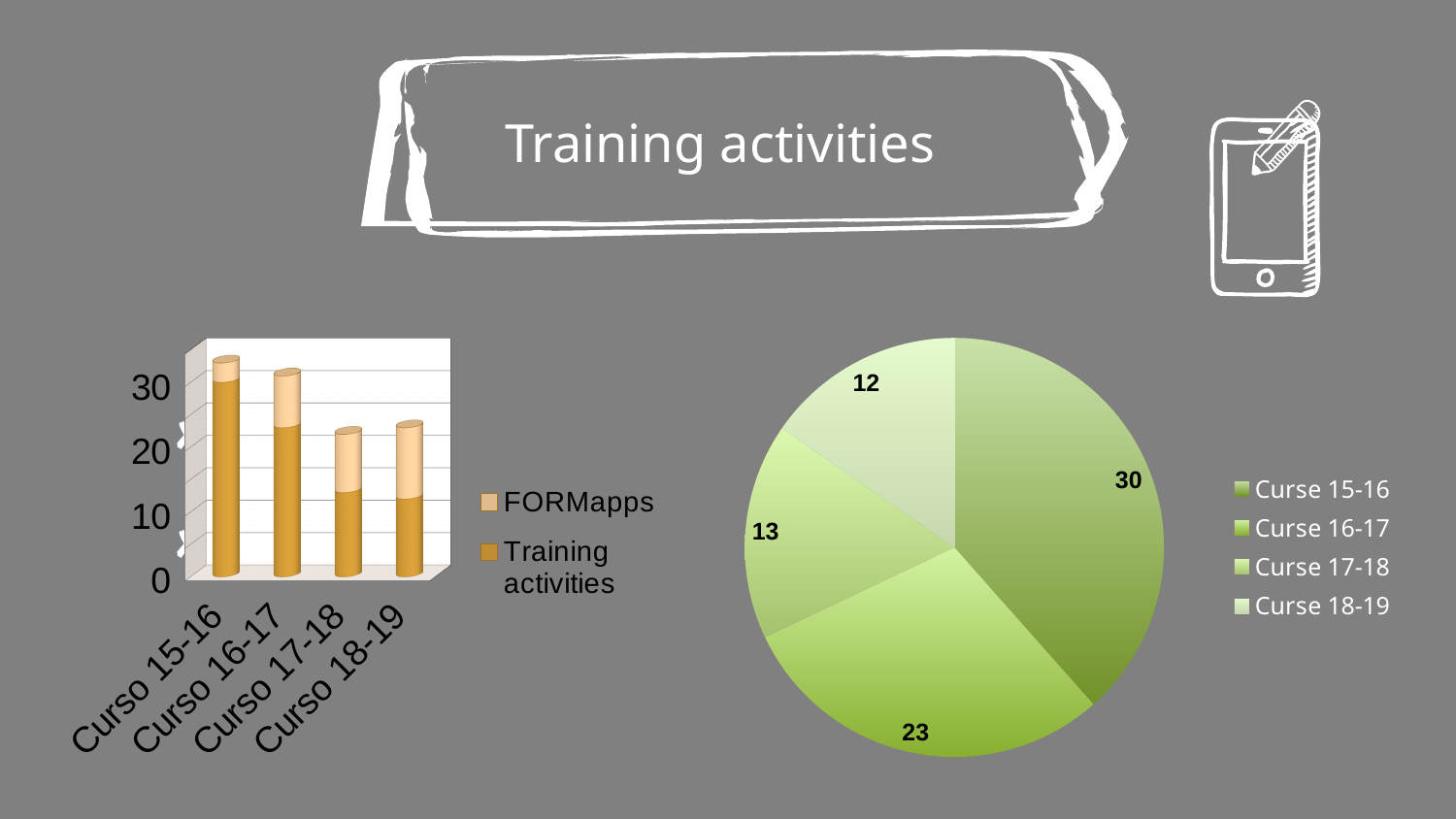
In the pie chart on the right, what is the value for Curse 15-16? 30 In the pie chart on the right, how many categories does the legend list? 4 In the bar chart on the left, which category has the tallest stacked bar? Curso 15-16 In the pie chart on the right, which category has the smallest slice? Curse 18-19 In the bar chart on the left, is the total stacked value for Curso 17-18 greater or less than 30? less In the bar chart on the left, how many series does the legend list? 2 In the pie chart on the right, what is the difference between the values for Curse 15-16 and Curse 16-17? 7 In the pie chart on the right, what is the value for Curse 17-18? 13 In the bar chart on the left, is the Training activities value for Curso 18-19 greater or less than 10? greater What kind of chart is the chart on the left of the slide? Bar chart In the pie chart on the right, what is the total of all four slices? 78 In the pie chart on the right, which category has the largest slice? Curse 15-16